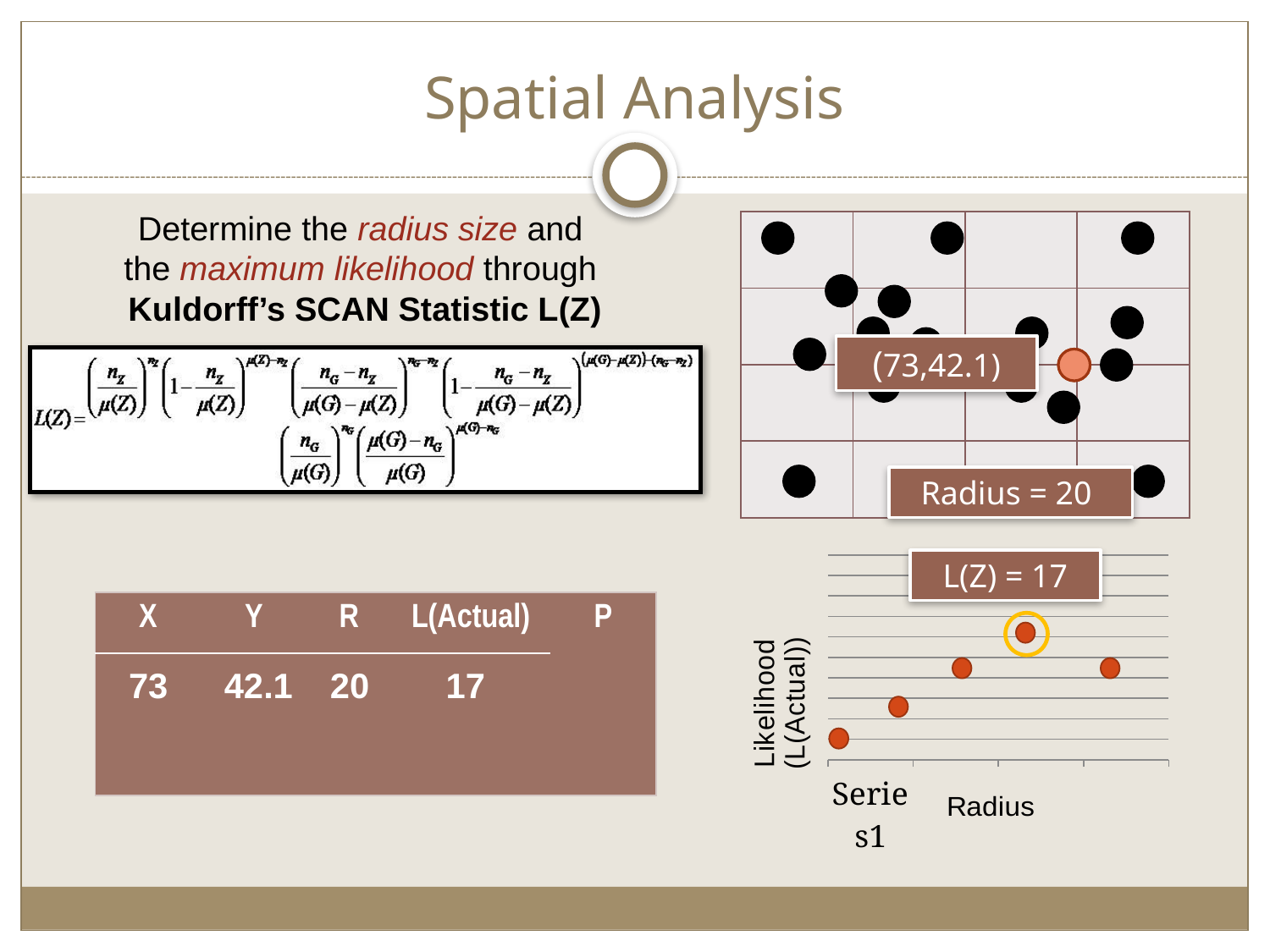
In the scatter chart, is the likelihood of the leftmost point larger or smaller than that of the rightmost point? smaller Which point in the scatter chart has the lowest likelihood: the first, second, third, fourth or fifth from the left? first What is the label of the horizontal axis of the scatter chart? Radius Which point in the scatter chart has the highest likelihood: the first, second, third, fourth or fifth from the left? fourth How many series does the legend of the Likelihood vs Radius chart list? 1 What likelihood value is labelled for the circled (highest) point in the scatter chart? L(Z) = 17 In the scatter chart, do the likelihood values rise or fall from the first point to the fourth point along the Radius axis? rise What kind of chart is shown at the bottom right of the slide? scatter chart In the scatter chart, does the likelihood rise or fall from the fourth point to the fifth point? fall What is the legend entry shown for the Likelihood vs Radius chart? Series1 In the scatter chart, which has the larger likelihood: the second point from the left or the fourth point from the left? fourth point How many data points are plotted in the Likelihood vs Radius chart? 5